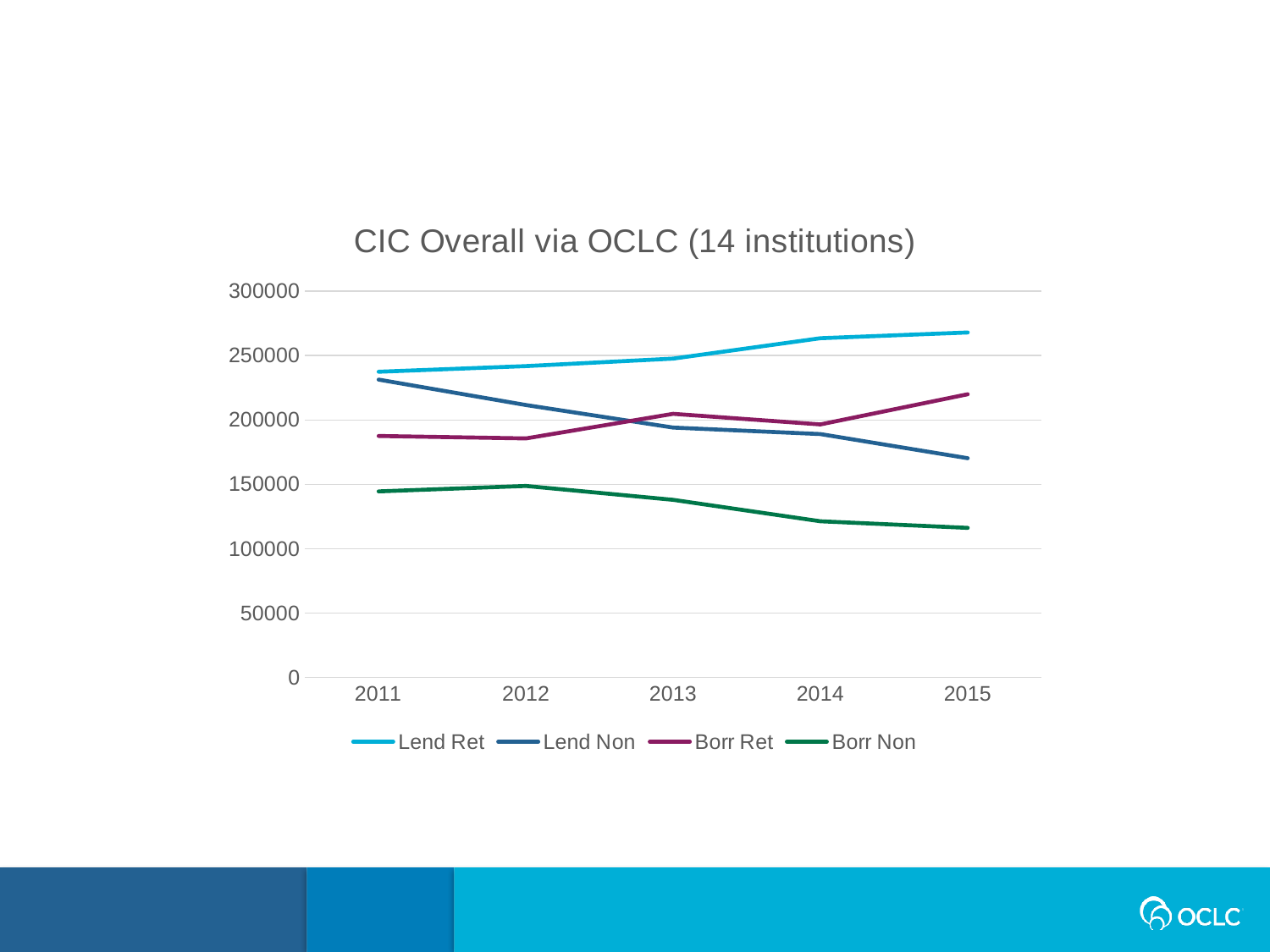
Is the value for Borr Non in 2015 greater or less than 150000? less Which series has the highest value in 2015? Lend Ret Is the value for Lend Ret in 2015 greater or less than 250000? greater Is the value for Lend Non in 2011 greater or less than 200000? greater In 2015, which is larger: Lend Ret or Borr Ret? Lend Ret How many series does the legend list? 4 Does the Lend Ret line rise or fall from 2011 to 2015? rise What kind of chart is shown on the slide? line chart Does the Lend Non line rise or fall from 2011 to 2015? fall What is the title of the chart? CIC Overall via OCLC (14 institutions) How many years are shown on the x axis? 5 Which series has the lowest value in 2011? Borr Non